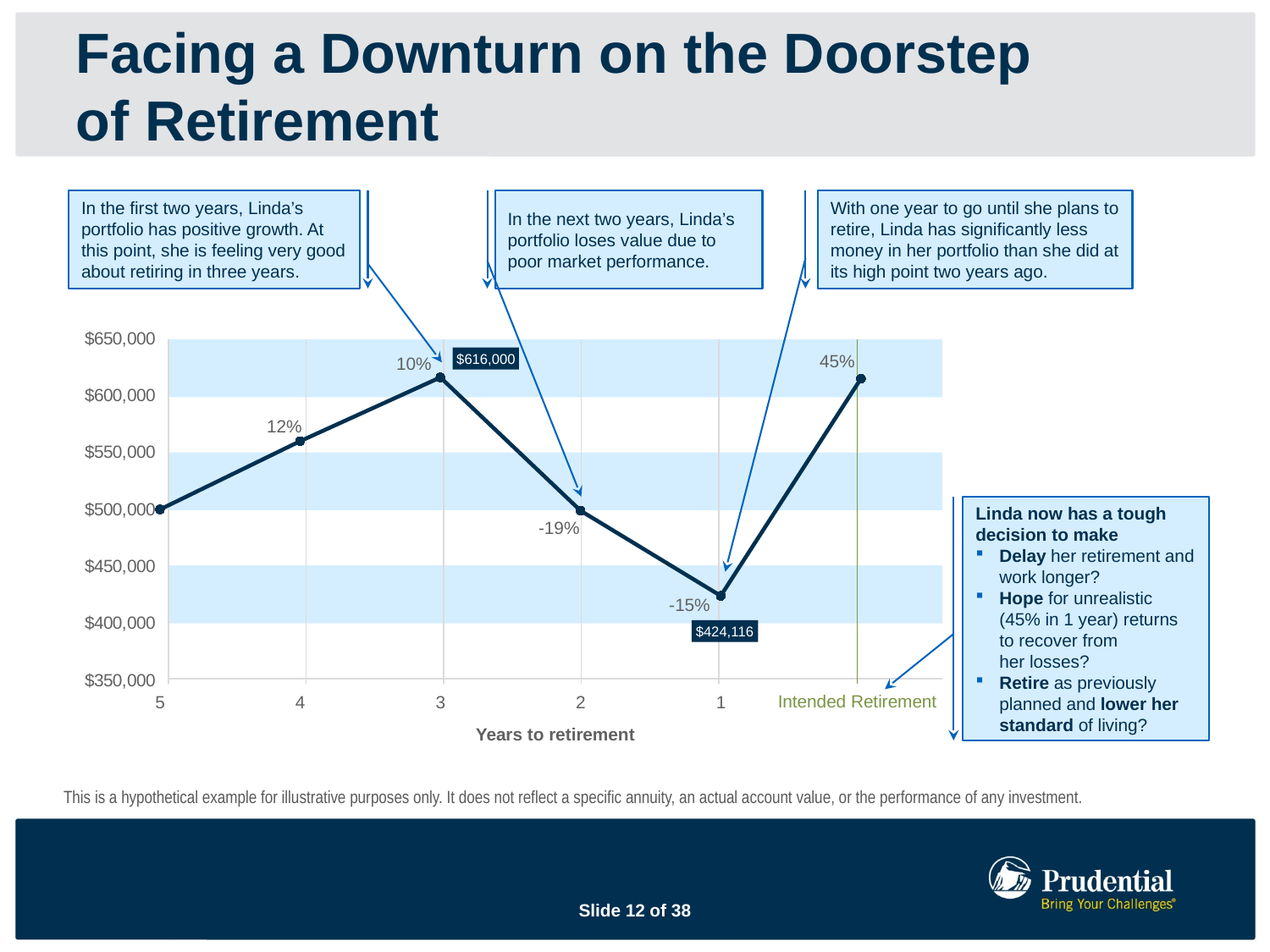
What kind of chart is shown on the slide? line chart At which point on the x axis is the portfolio value lowest? 1 How many data points are plotted on the line? 6 What is the portfolio value at 5 years to retirement? $500,000 What percentage change is labelled at 2 years to retirement? -19% What percentage change is labelled at the Intended Retirement point? 45% What is the portfolio value at 3 years to retirement? $616,000 What is the title of the x axis? Years to retirement What percentage change is labelled at 4 years to retirement? 12% What is the difference between the portfolio value at 3 years to retirement and at 1 year to retirement? $191,884 Is the portfolio value at 4 years to retirement greater or less than $600,000? less What is the portfolio value at 1 year to retirement? $424,116